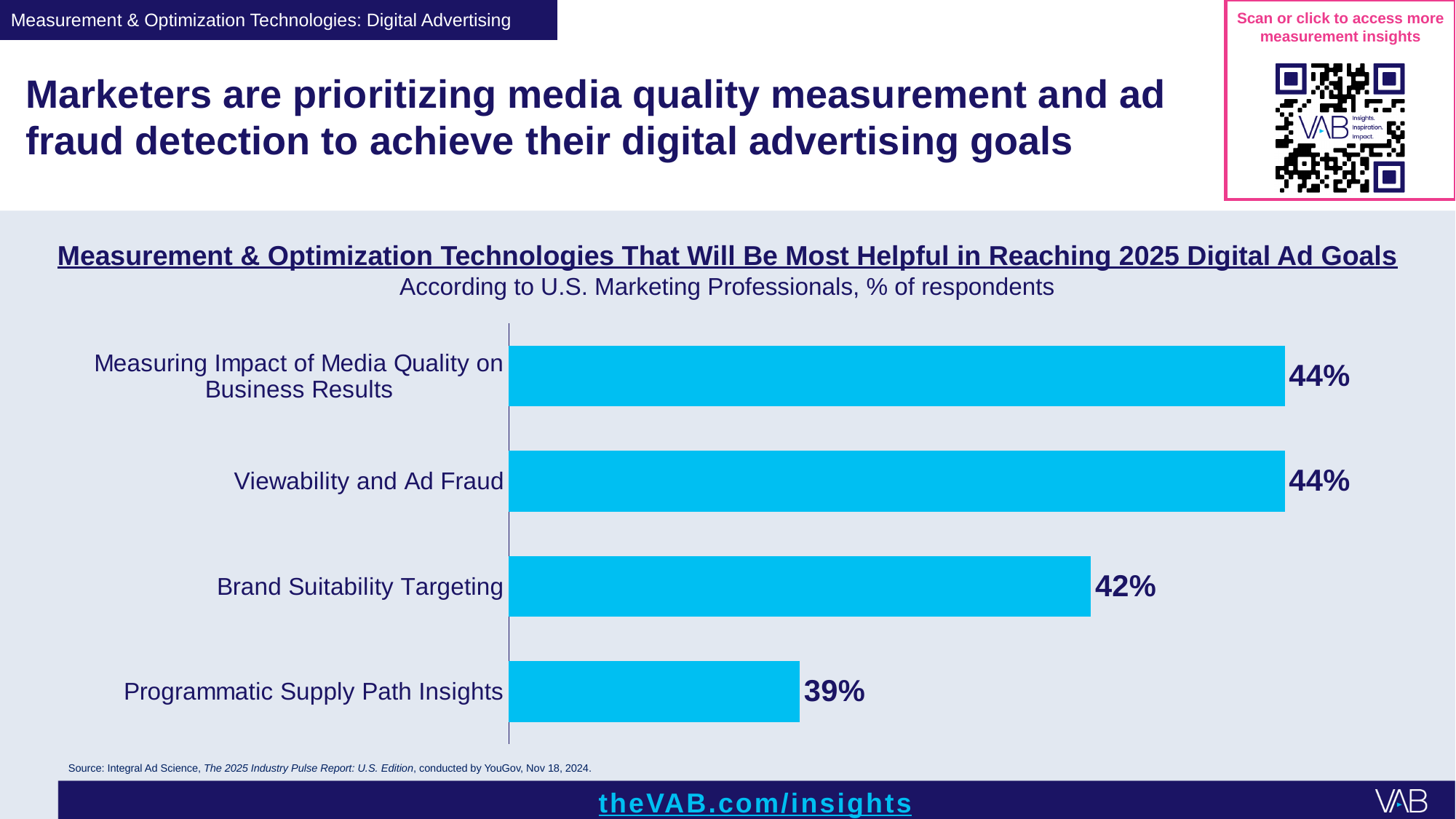
How many categories are shown in the chart? 4 What is the value for Measuring Impact of Media Quality on Business Results? 44% Which category has the lowest value? Programmatic Supply Path Insights What is the title of the chart? Measurement & Optimization Technologies That Will Be Most Helpful in Reaching 2025 Digital Ad Goals What kind of chart is shown on the slide? Bar chart What percentage of respondents selected Brand Suitability Targeting? 42% Which is larger, Brand Suitability Targeting or Programmatic Supply Path Insights? Brand Suitability Targeting What percentage of respondents selected Viewability and Ad Fraud? 44% What is the value for Programmatic Supply Path Insights? 39% What colour are the bars in the chart? Light blue What is the difference between Viewability and Ad Fraud and Brand Suitability Targeting? 2% What is the difference between Brand Suitability Targeting and Programmatic Supply Path Insights? 3%